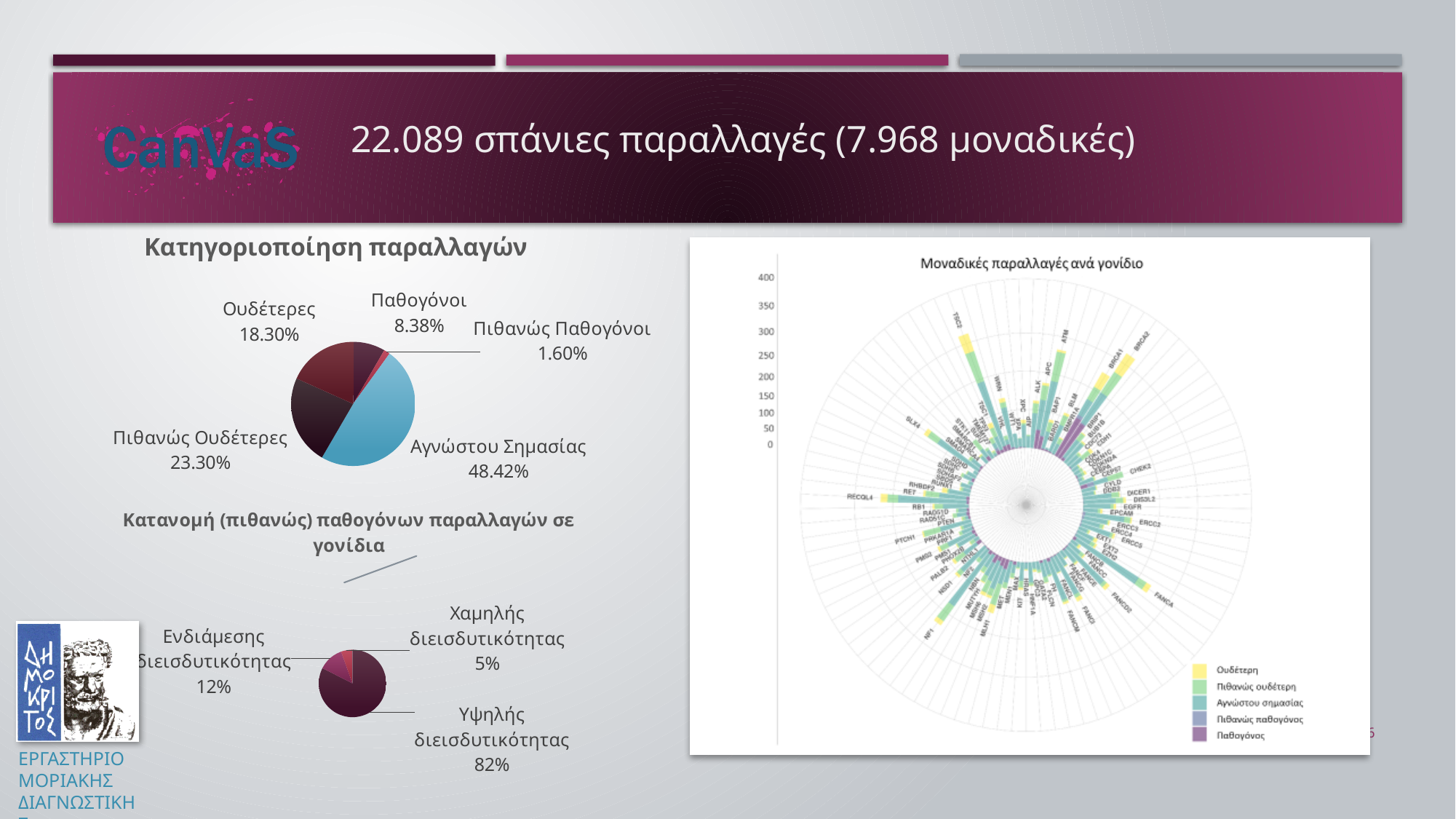
In the pie chart 'Κατηγοριοποίηση παραλλαγών', which category has the largest share? Αγνώστου Σημασίας In the pie chart 'Κατανομή (πιθανώς) παθογόνων παραλλαγών σε γονίδια', what is the share for 'Υψηλής διεισδυτικότητας'? 82% In the pie chart 'Κατανομή (πιθανώς) παθογόνων παραλλαγών σε γονίδια', what is the share for 'Ενδιάμεσης διεισδυτικότητας'? 12% In the pie chart 'Κατηγοριοποίηση παραλλαγών', what is the share for 'Αγνώστου Σημασίας'? 48.42% In the pie chart 'Κατηγοριοποίηση παραλλαγών', which is larger: 'Παθογόνοι' or 'Ουδέτερες'? Ουδέτερες In the pie chart 'Κατηγοριοποίηση παραλλαγών', which category has the smallest share? Πιθανώς Παθογόνοι How many slices does the pie chart 'Κατηγοριοποίηση παραλλαγών' have? 5 In the pie chart 'Κατηγοριοποίηση παραλλαγών', what is the difference between the shares of 'Πιθανώς Ουδέτερες' and 'Ουδέτερες'? 5.00% In the pie chart 'Κατανομή (πιθανώς) παθογόνων παραλλαγών σε γονίδια', which category has the smallest share? Χαμηλής διεισδυτικότητας In the pie chart 'Κατηγοριοποίηση παραλλαγών', what is the share for 'Πιθανώς Παθογόνοι'? 1.60% How many entries does the legend of the chart 'Μοναδικές παραλλαγές ανά γονίδιο' list? 5 What type of chart is 'Κατηγοριοποίηση παραλλαγών'? Pie chart